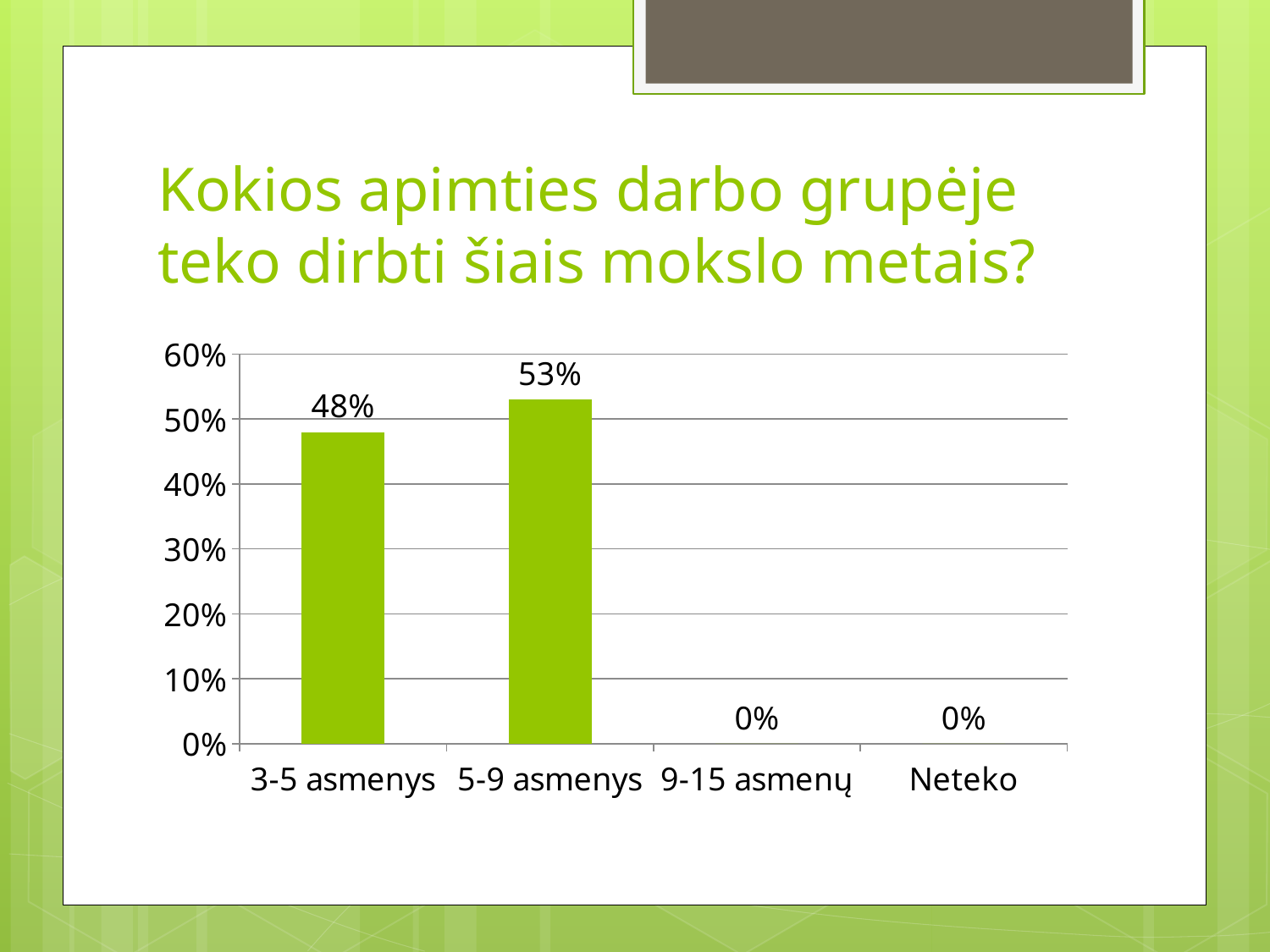
Is the value for 3-5 asmenys greater or less than 40%? greater What is the value for 9-15 asmenų? 0% What is the difference between the values for 5-9 asmenys and 3-5 asmenys? 5% What kind of chart is shown on the slide? bar chart What is the value for 5-9 asmenys? 53% What is the value for 3-5 asmenys? 48% What is the title of the slide above the chart? Kokios apimties darbo grupėje teko dirbti šiais mokslo metais? What is the value for Neteko? 0% Is the value for 5-9 asmenys greater or less than 60%? less How many categories are shown on the x axis? 4 Which is larger, the value for 3-5 asmenys or the value for 5-9 asmenys? 5-9 asmenys Which category has the highest value? 5-9 asmenys